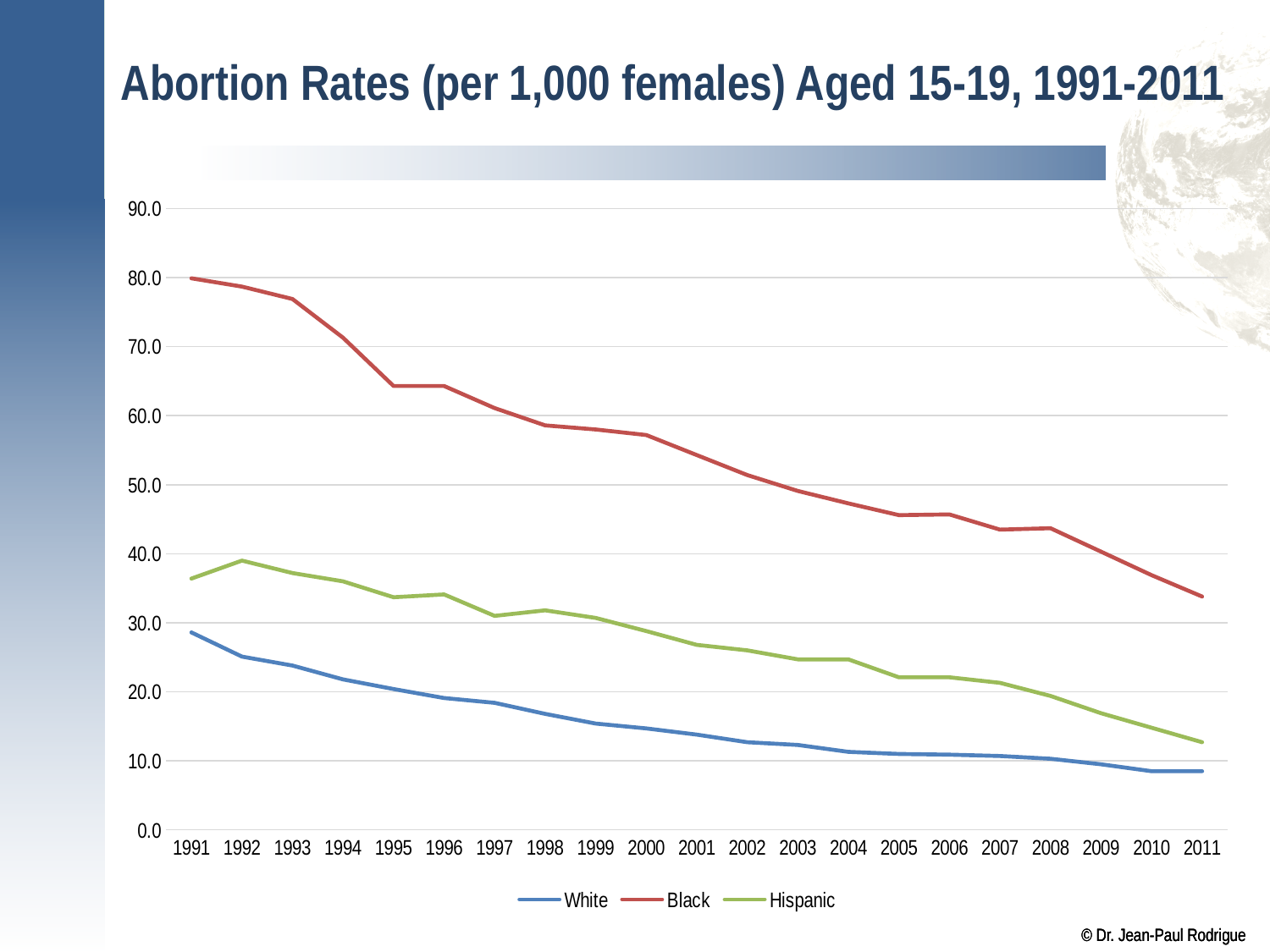
Is the value for Black in 2011 greater or less than 40? less What colour is the line for the Black series? red Is the value for Black in 1991 greater or less than 70? greater Which series has the lowest abortion rate in 2011? White Does the abortion rate for Black females rise or fall from 1991 to 2011? fall In 2000, which is larger, the value for Hispanic or the value for White? Hispanic What kind of chart is shown on the slide? line chart Which series has the highest abortion rate in 1991? Black Is the value for White in 2011 greater or less than 10? less How many series does the legend list? 3 How many years are plotted along the x axis? 21